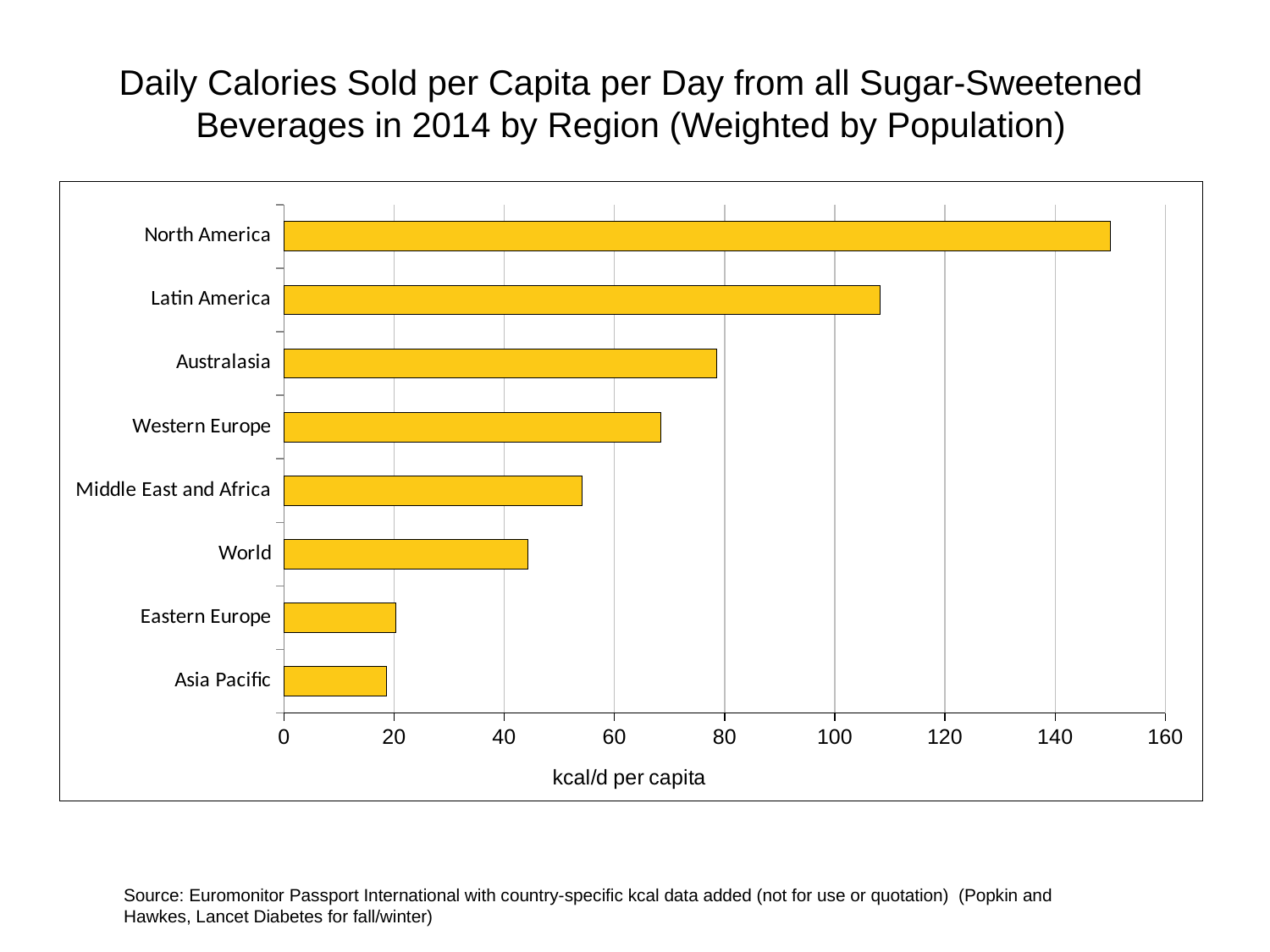
What kind of chart is shown on the slide? bar chart Is the value for World greater or less than 40 kcal/d per capita? greater Which region has the highest daily calories sold per capita from sugar-sweetened beverages? North America Is the value for North America greater or less than 140 kcal/d per capita? greater Which has the larger value, World or Middle East and Africa? Middle East and Africa What is the label on the horizontal axis of the chart? kcal/d per capita Is the value for Australasia greater or less than 60 kcal/d per capita? greater How many regions are plotted in the chart? 8 Which has the larger value, Latin America or Western Europe? Latin America